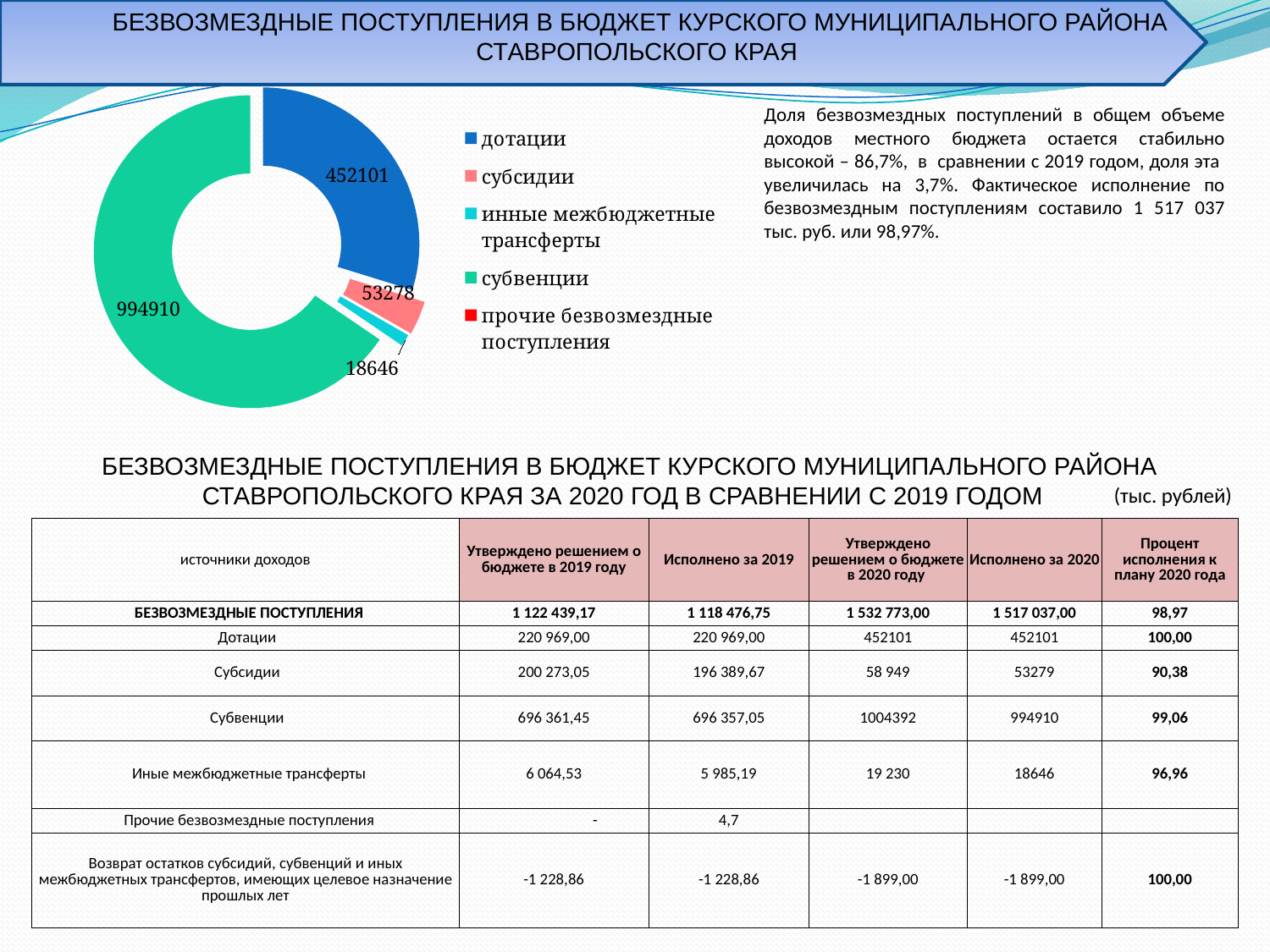
What kind of chart is shown on the slide? Doughnut (pie) chart What value is shown for иные межбюджетные трансферты in the doughnut chart? 18646 What colour is the субвенции slice in the doughnut chart? Green What is the difference between the values for субвенции and дотации in the doughnut chart? 542809 What value is shown for субсидии in the doughnut chart? 53278 Which category has the largest slice in the doughnut chart? субвенции Which is larger in the doughnut chart: дотации or субсидии? дотации What value is shown for субвенции in the doughnut chart? 994910 What is the difference between the values for субсидии and иные межбюджетные трансферты in the doughnut chart? 34632 How many categories does the legend of the doughnut chart list? 5 What value is shown for дотации in the doughnut chart? 452101 Which is larger in the doughnut chart: субсидии or иные межбюджетные трансферты? субсидии